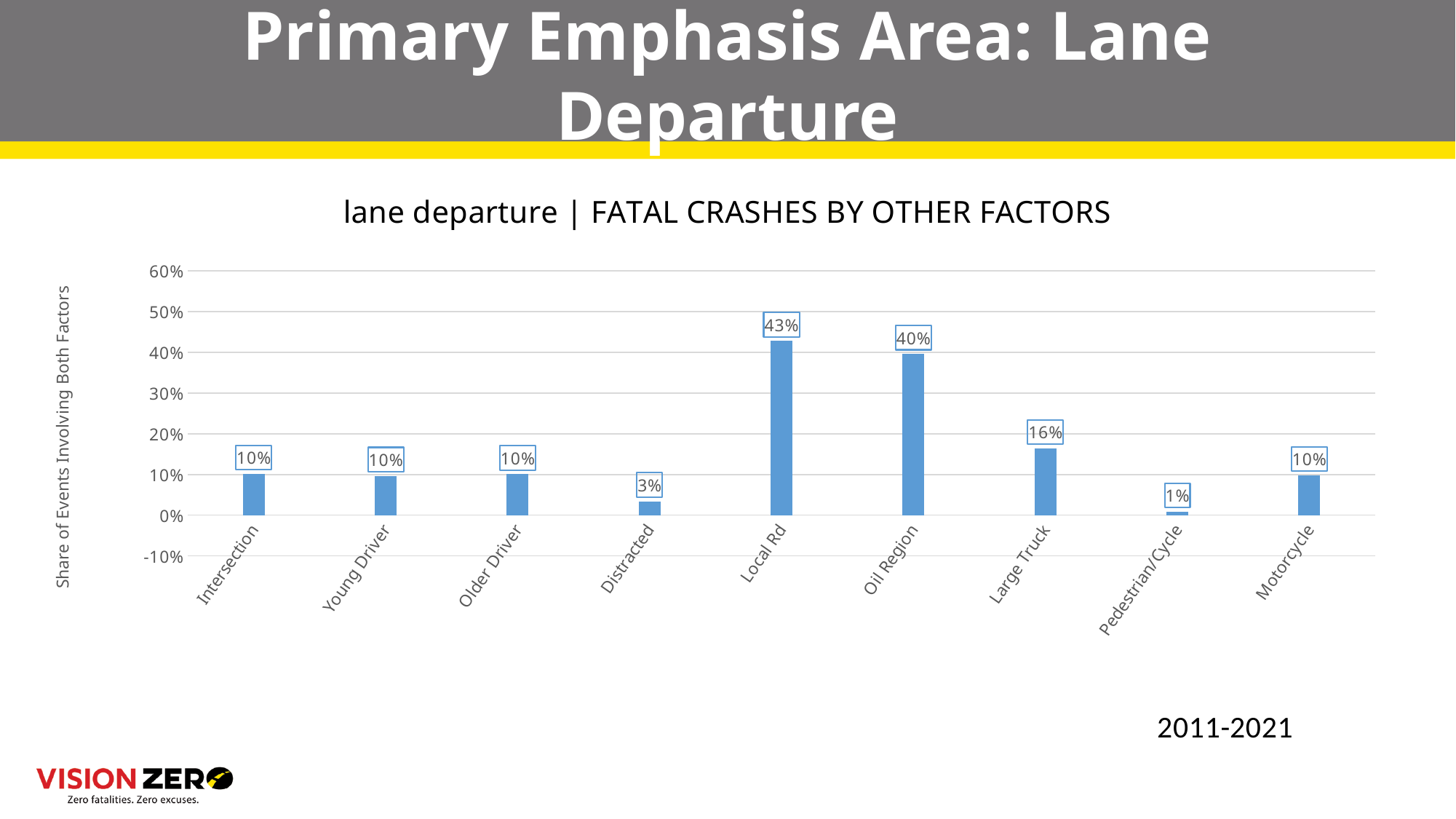
What is the value for Pedestrian/Cycle? 1% Which category has the highest value? Local Rd How many categories are shown on the x axis? 9 What kind of chart is shown on the slide? Bar chart What is the value for Distracted? 3% Which category has the lowest value? Pedestrian/Cycle What is the value for Large Truck? 16% What is the value for Oil Region? 40% What is the value for Local Rd? 43% Which is larger, the value for Large Truck or the value for Motorcycle? Large Truck What is the difference between the values for Local Rd and Oil Region? 3% What is the title of the chart? lane departure | FATAL CRASHES BY OTHER FACTORS